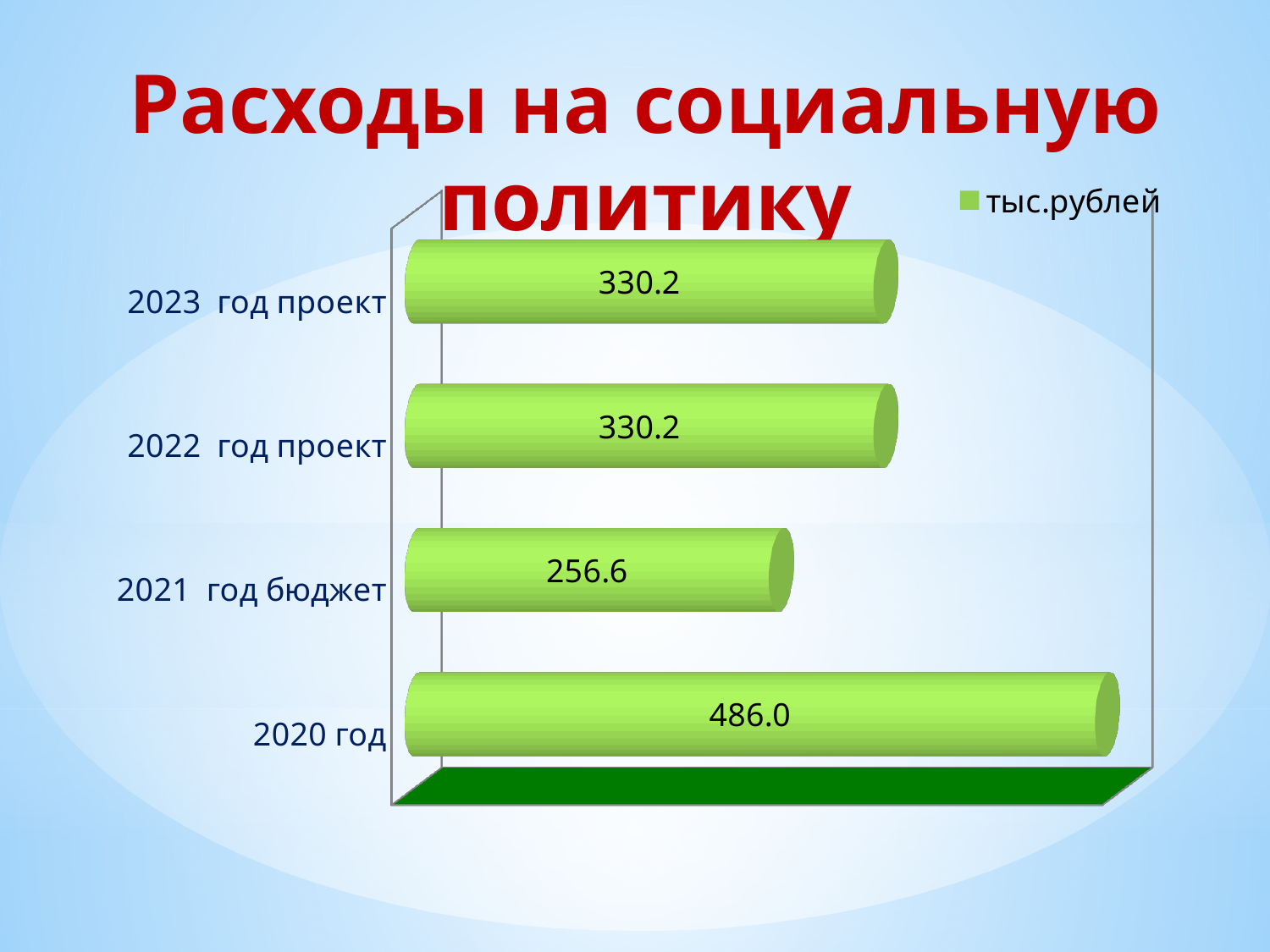
What is the value for 2022 год проект? 330.2 What is the value for 2021 год бюджет? 256.6 Which is larger, the value for 2020 год or the value for 2023 год проект? 2020 год What is the legend entry shown for the series? тыс.рублей What is the difference between the values for 2020 год and 2021 год бюджет? 229.4 What kind of chart is shown on the slide? Bar chart How many categories are shown in the chart? 4 What is the value for 2020 год? 486.0 Which category has the highest value? 2020 год What is the difference between the values for 2022 год проект and 2021 год бюджет? 73.6 Which category has the lowest value? 2021 год бюджет What is the value for 2023 год проект? 330.2